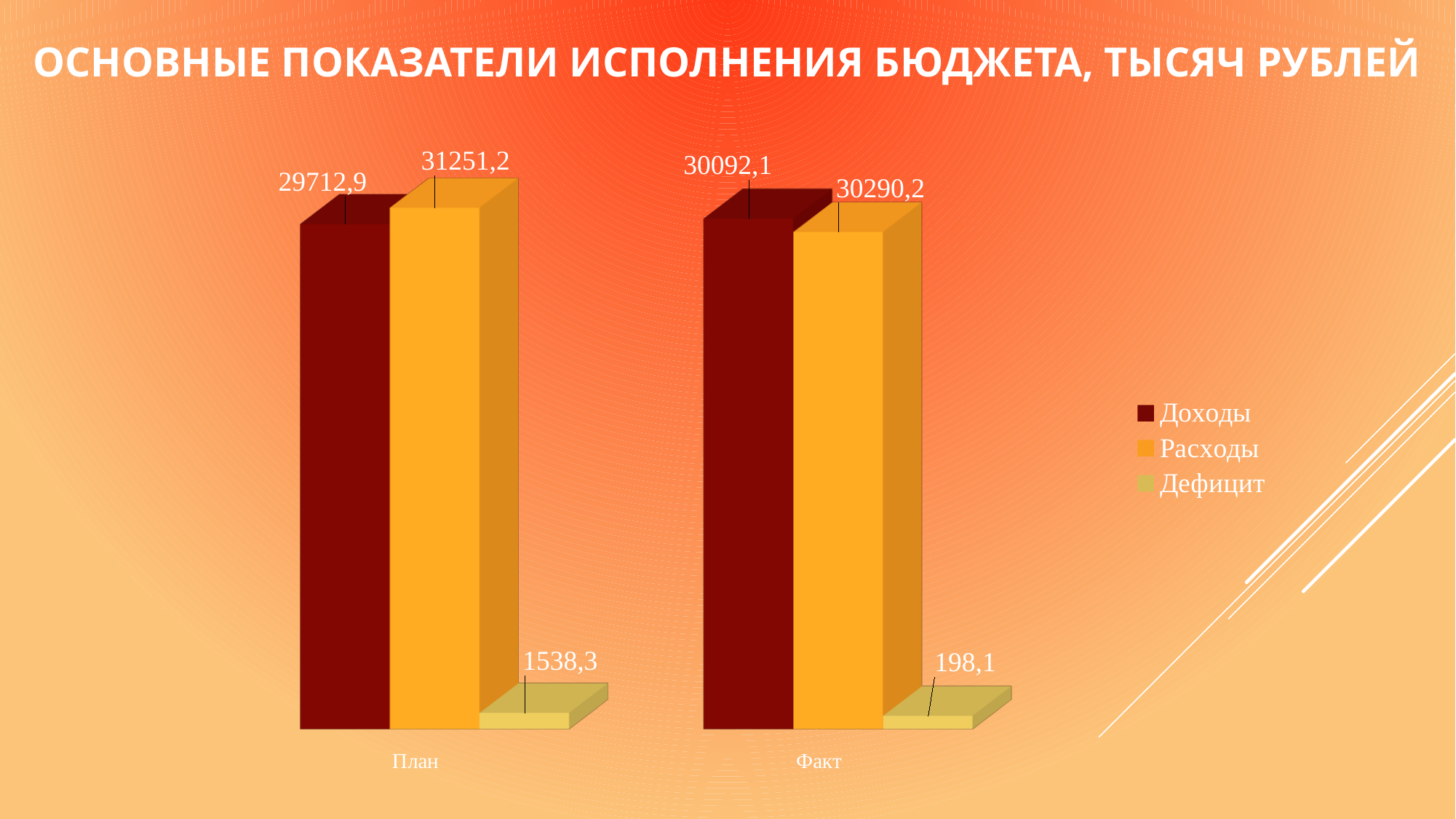
What is the value of Доходы for План? 29712,9 What kind of chart is shown on the slide? Bar chart Which series has the lowest value in the Факт category? Дефицит How many series does the legend list? 3 What is the difference between Дефицит for План and Дефицит for Факт? 1340,2 Which series has the highest value in the План category? Расходы What is the value of Дефицит for План? 1538,3 Which is larger for План: Доходы or Расходы? Расходы What is the value of Расходы for Факт? 30290,2 What is the value of Дефицит for Факт? 198,1 How many categories are shown on the x axis? 2 What is the difference between Расходы and Доходы for План? 1538,3